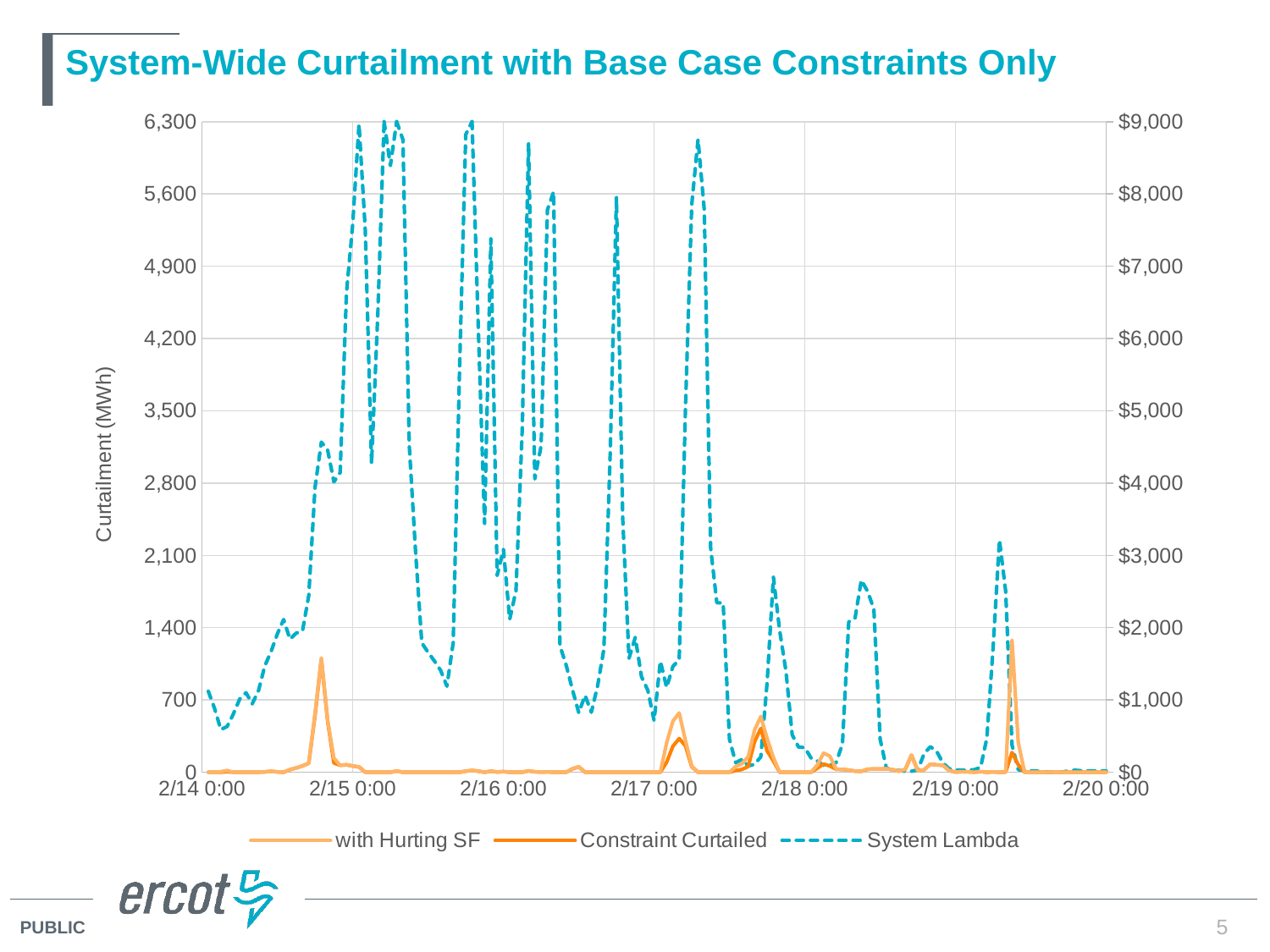
What is the title of the chart? System-Wide Curtailment with Base Case Constraints Only How many series does the legend list? 3 Does the System Lambda series generally rise or fall between 2/14 0:00 and 2/15 0:00? rise What type of chart is shown on the slide? line chart Is the peak of the System Lambda series shortly after 2/19 0:00 greater or less than $2,000? greater At the spike just after 2/17 0:00, which series is higher: 'with Hurting SF' or 'Constraint Curtailed'? with Hurting SF Is the peak of the System Lambda series shortly after 2/19 0:00 greater or less than $4,000? less Of the two curtailment series, which reaches the higher peak over the whole chart? with Hurting SF Is the peak of the 'Constraint Curtailed' series near 2/17 0:00 greater or less than 700 MWh? less Which series is drawn with a dashed line? System Lambda